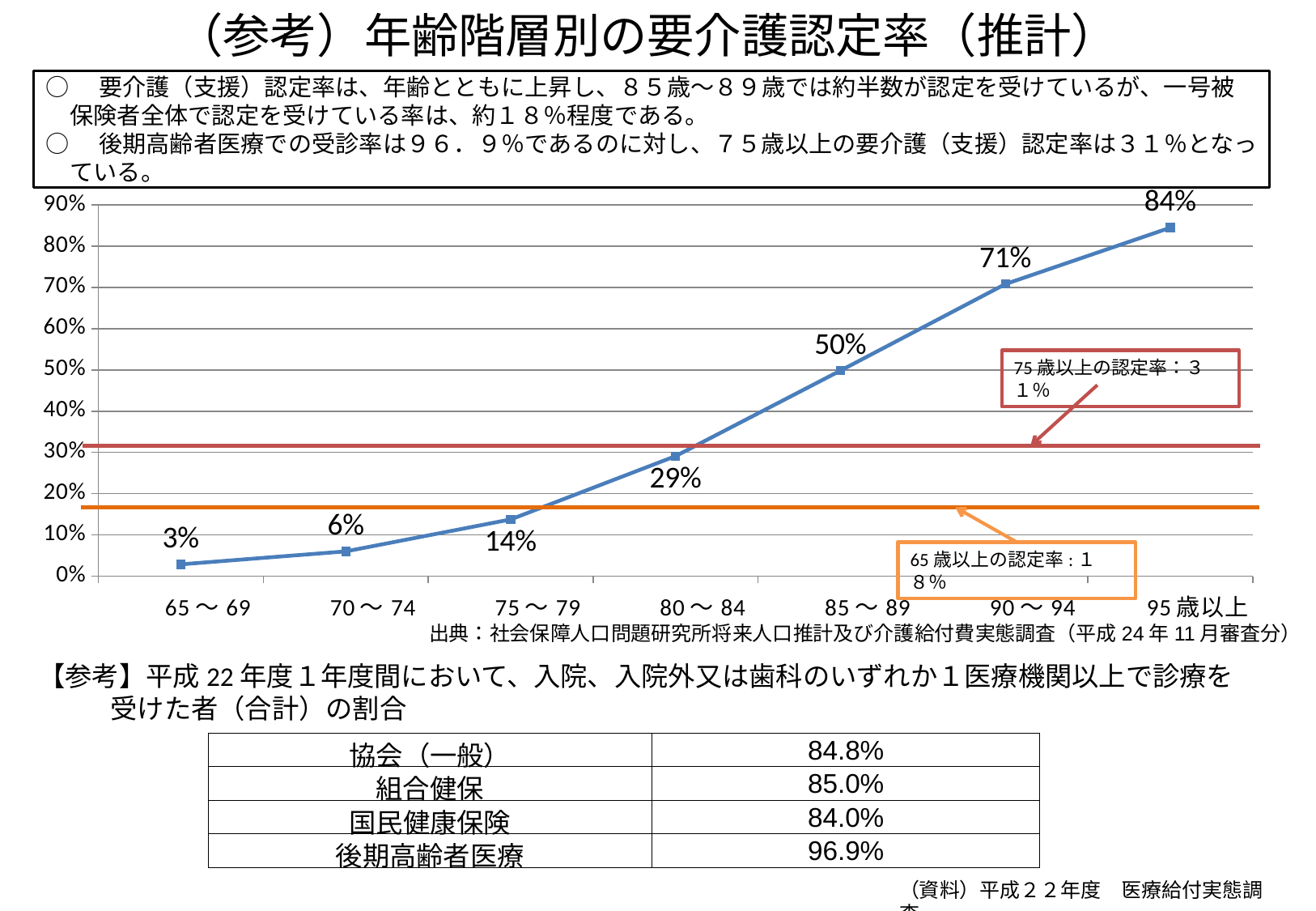
Which age group has the highest certification rate? 95歳以上 Which age group has the lowest certification rate? 65～69 What is the certification rate for the 95歳以上 age group? 84% Do the certification rates rise or fall as age increases along the x axis? Rise What is the certification rate for the 85～89 age group? 50% What certification rate does the red horizontal reference line represent, according to its label? 31% (75歳以上の認定率) What certification rate does the orange horizontal reference line represent, according to its label? 18% (65歳以上の認定率) Which is larger, the certification rate for 75～79 or for 70～74? 75～79 What kind of chart is shown on the slide? Line chart What is the difference between the certification rates for 90～94 and 80～84? 42% What is the certification rate for the 65～69 age group? 3% How many age groups are plotted on the x axis? 7